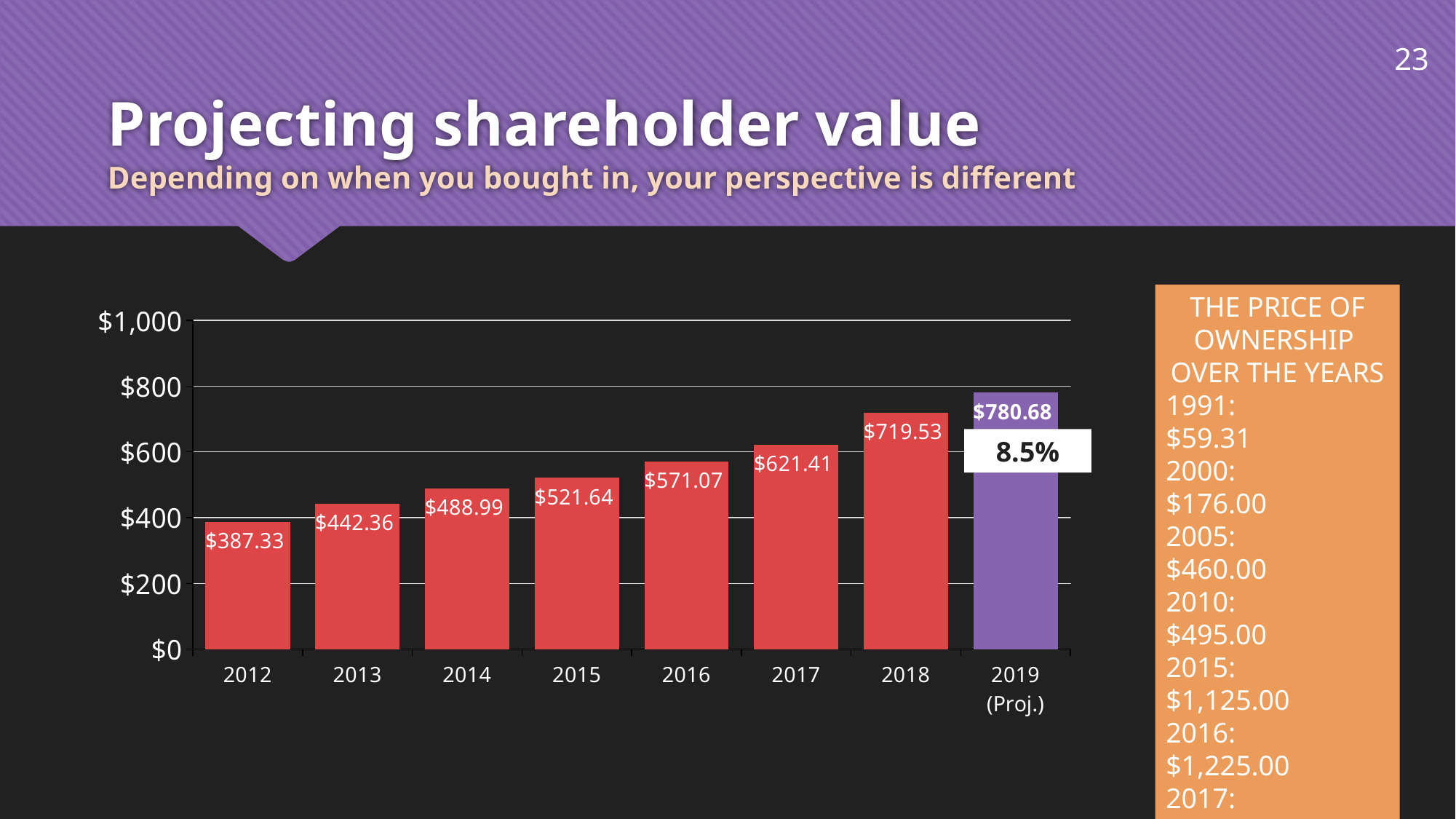
What percentage is shown in the white label next to the 2019 bar? 8.5% Which is larger, the value for 2014 or the value for 2015? 2015 How many years are shown on the x axis of the chart? 8 What is the projected value shown for 2019? $780.68 What kind of chart is shown on the slide? Bar chart What is the difference between the 2018 value and the 2017 value? $98.12 What is the value shown for 2012? $387.33 Which year has the lowest value on the chart? 2012 Which year has the highest value on the chart? 2019 (Proj.) Do the values rise or fall from 2012 to 2019? Rise Is the value for 2013 greater or less than $400? greater What is the value shown for 2016? $571.07